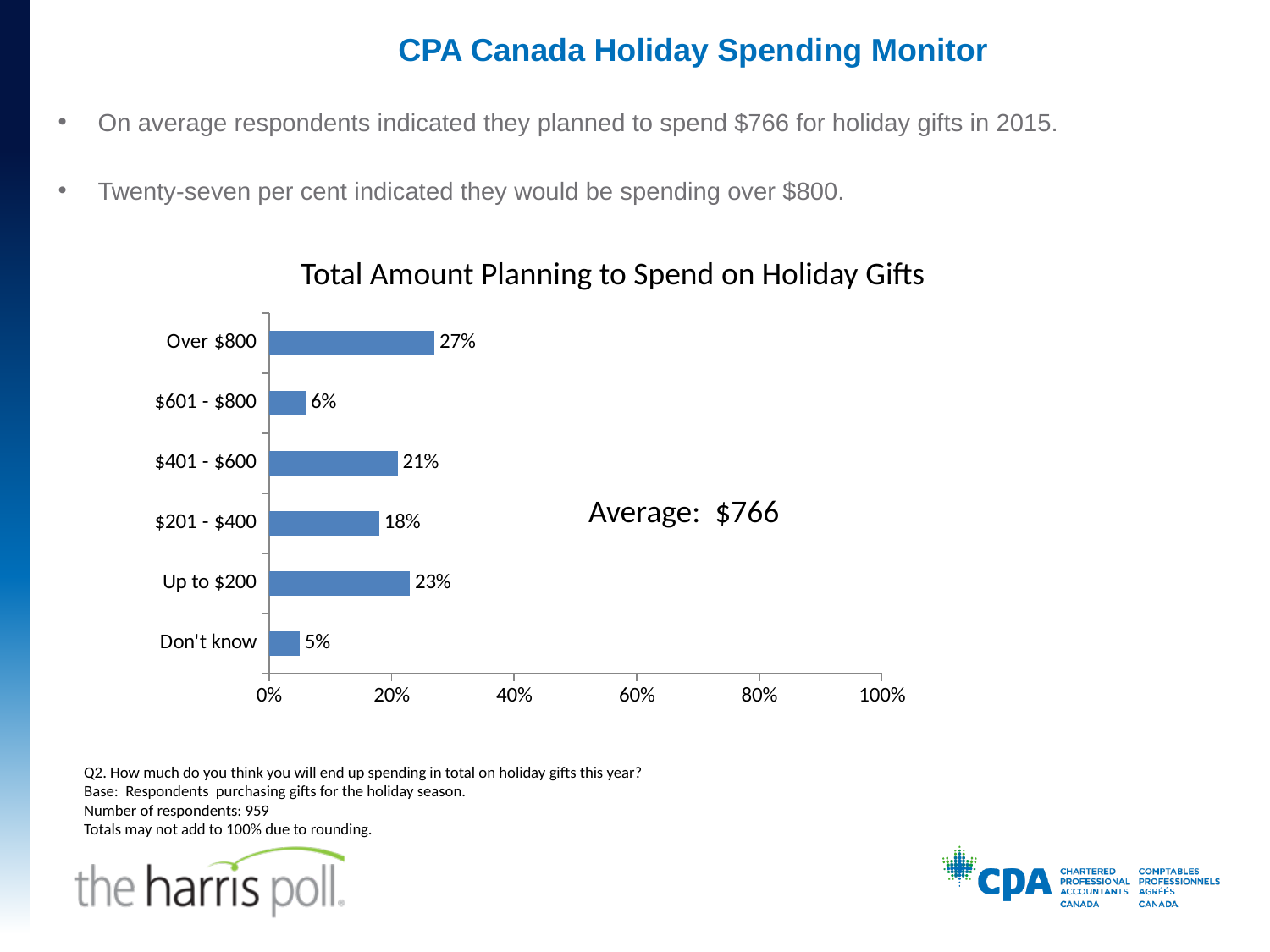
What kind of chart is shown on the slide? Bar chart What average amount is annotated on the chart? $766 What percentage of respondents plan to spend up to $200? 23% How many categories are shown in the chart? 6 Which category has the lowest value in the chart? Don't know What is the value for the "$601 - $800" category? 6% What is the difference between the "$401 - $600" and "$201 - $400" values? 3% Which is larger, the value for "Up to $200" or the value for "$401 - $600"? Up to $200 What percentage of respondents plan to spend over $800 on holiday gifts? 27% Is the value for "Over $800" greater or less than 20%? greater Which category has the highest value in the chart? Over $800 What is the title of the chart? Total Amount Planning to Spend on Holiday Gifts